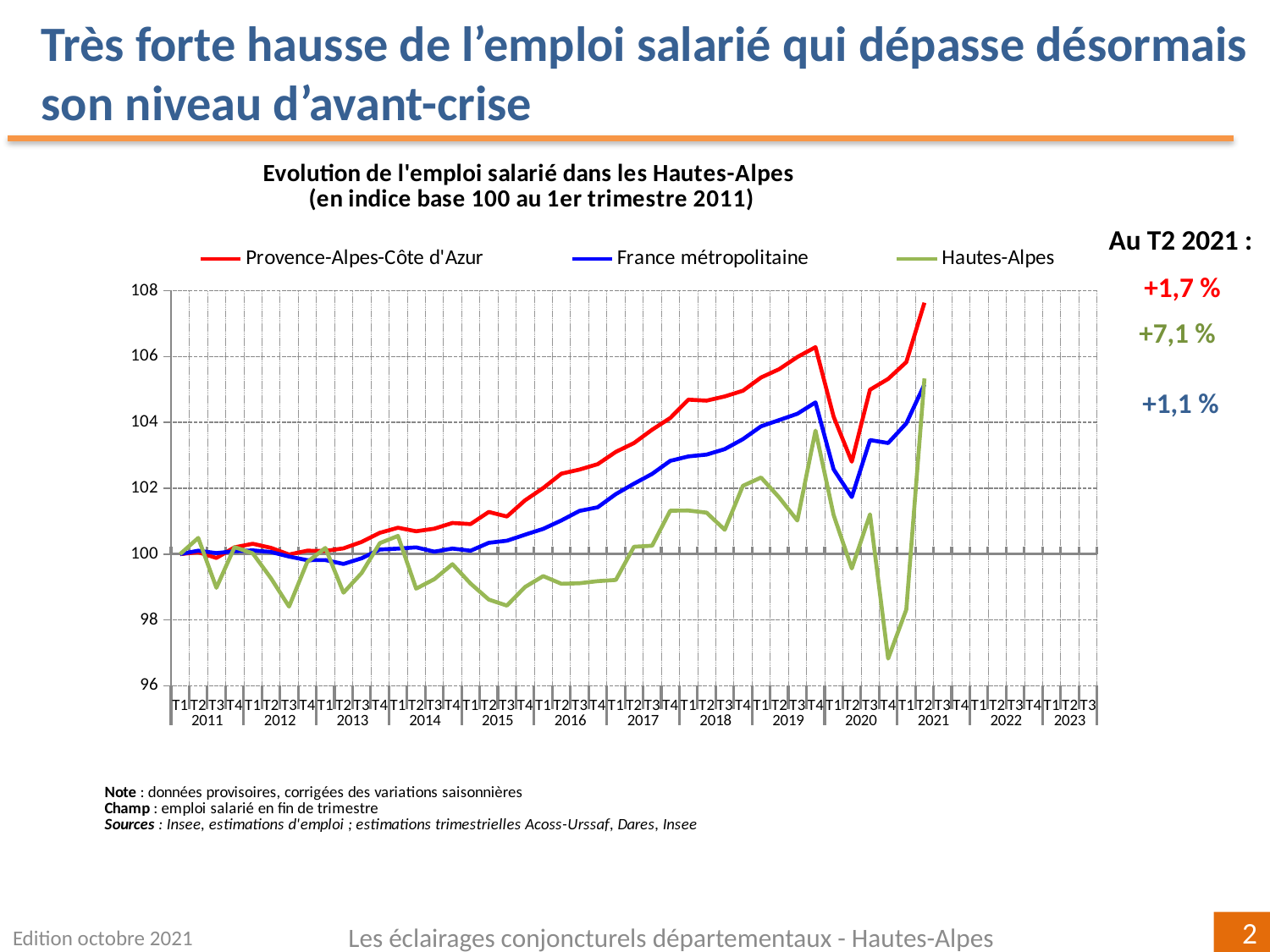
What kind of chart is shown on the slide? line chart What is the title of the chart? Evolution de l'emploi salarié dans les Hautes-Alpes (en indice base 100 au 1er trimestre 2011) According to the annotation on the slide, what is the change in salaried employment for Hautes-Alpes at T2 2021? +7,1 % At T4 2019, which series has the higher index value, Provence-Alpes-Côte d'Azur or Hautes-Alpes? Provence-Alpes-Côte d'Azur Is the Hautes-Alpes index value at T4 2020 greater or less than 98? less According to the annotation on the slide, what is the change for France métropolitaine at T2 2021? +1,1 % Which series has the lowest index value at T4 2020? Hautes-Alpes Which series reaches the highest index value at T2 2021? Provence-Alpes-Côte d'Azur According to the annotation on the slide, what is the change for Provence-Alpes-Côte d'Azur at T2 2021? +1,7 % Does the Provence-Alpes-Côte d'Azur line generally rise or fall between 2011 and 2019? rise Is the Provence-Alpes-Côte d'Azur index value at T2 2021 greater or less than 106? greater How many series does the legend of the chart list? 3